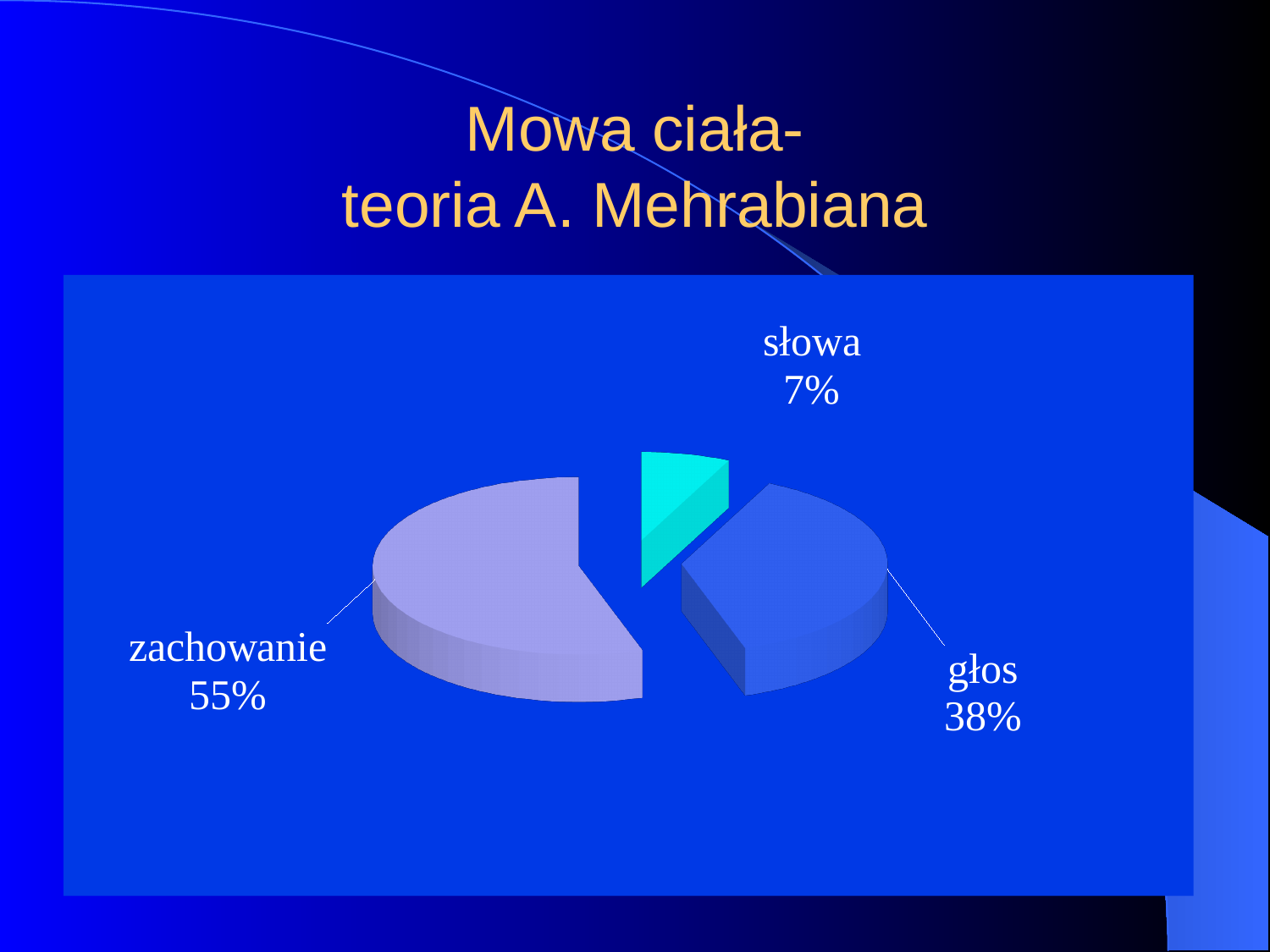
What is the difference in percentage points between "zachowanie" and "głos"? 17 What percentage does the "głos" slice represent? 38% What kind of chart is shown on the slide? pie chart What is the difference in percentage points between "głos" and "słowa"? 31 Which slice is drawn in cyan? słowa Which slice of the pie is the smallest? słowa Which is larger, the "głos" slice or the "słowa" slice? głos What is the title of the slide containing the chart? Mowa ciała- teoria A. Mehrabiana How many slices does the pie chart have? 3 Which slice of the pie is the largest? zachowanie What percentage does the "słowa" slice represent? 7% What percentage does the "zachowanie" slice represent? 55%